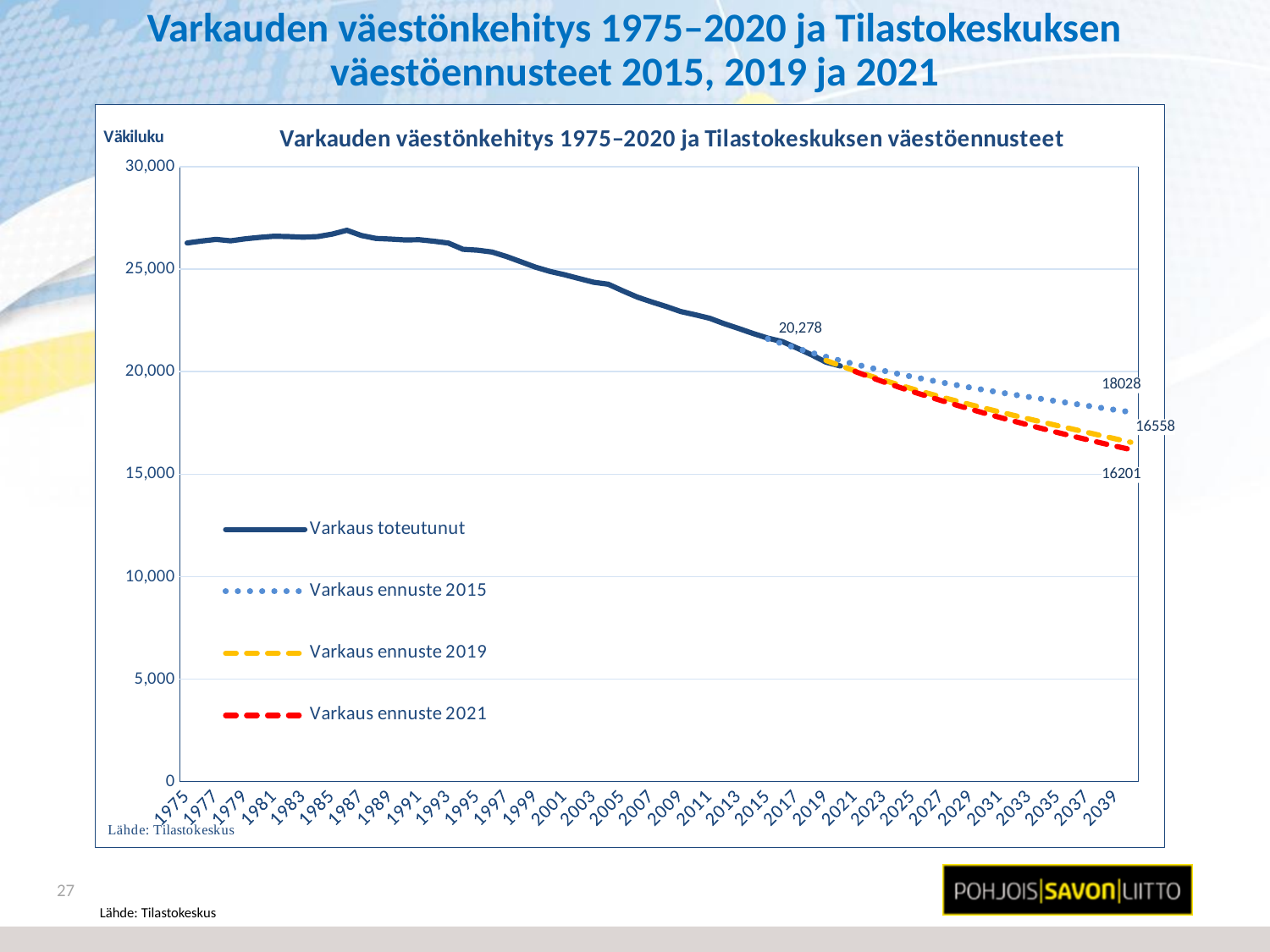
What label is shown on the vertical axis of the chart? Väkiluku What is the final labelled value of the Varkaus ennuste 2019 series? 16558 How many series does the chart legend list? 4 What is the difference between the final labelled values of Varkaus ennuste 2019 (16558) and Varkaus ennuste 2021 (16201)? 357 What is the final labelled value of the Varkaus ennuste 2021 series? 16201 What is the final labelled value of the Varkaus ennuste 2015 series? 18028 Which forecast series ends at the lowest value: Varkaus ennuste 2015, 2019 or 2021? Varkaus ennuste 2021 Does the Varkaus toteutunut line rise or fall from 1987 to 2020? falls What value is labelled on the Varkaus toteutunut line near its end? 20,278 Is the value of Varkaus toteutunut in 1975 greater or less than 25,000? greater What kind of chart is shown on the slide? line chart What is the difference between the final labelled values of Varkaus ennuste 2015 (18028) and Varkaus ennuste 2021 (16201)? 1827